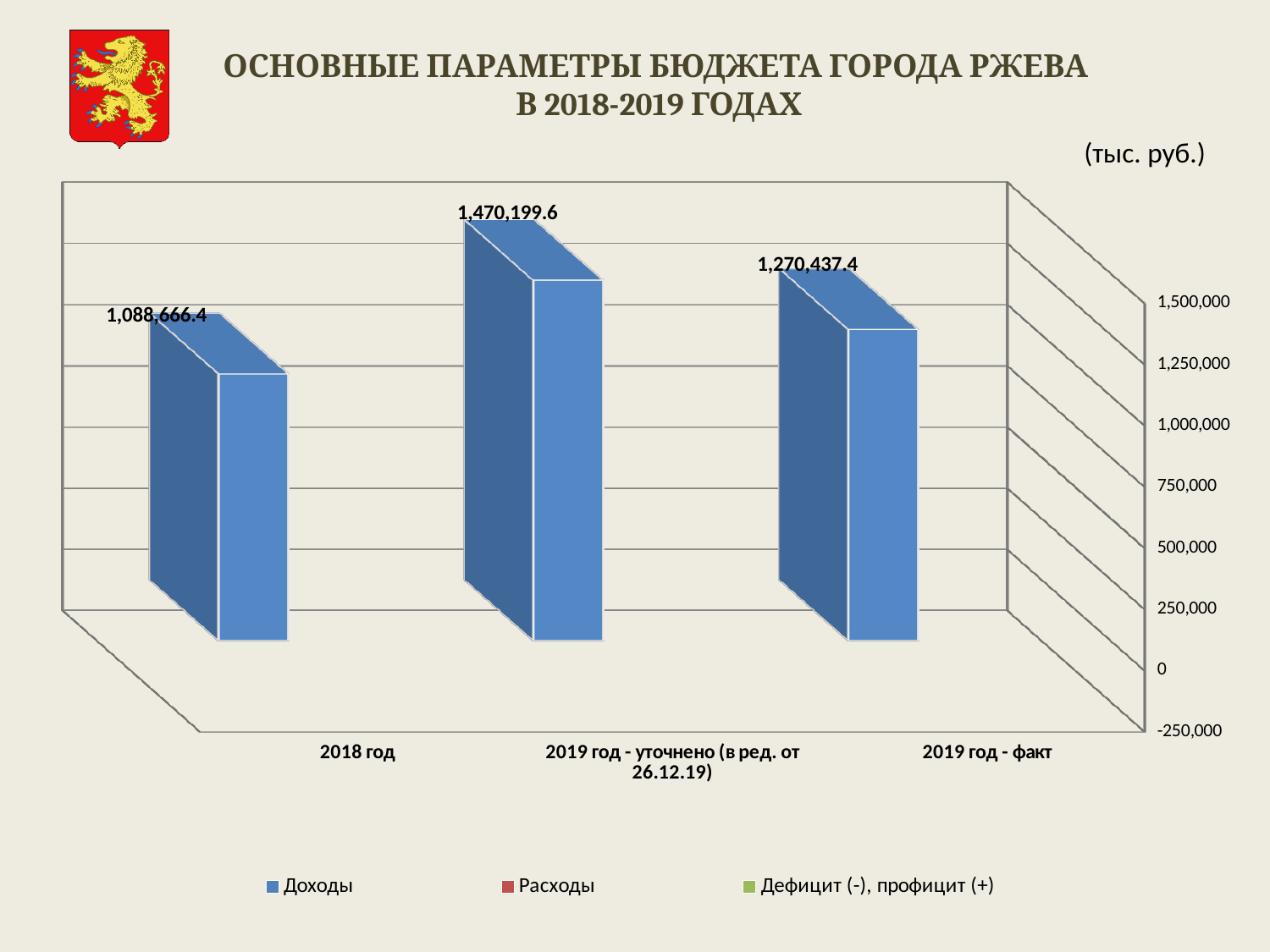
What is the difference between the Доходы values for 2019 год - уточнено (в ред. от 26.12.19) and 2019 год - факт? 199,762.2 What kind of chart is shown on the slide? bar chart Which category has the highest Доходы value? 2019 год - уточнено (в ред. от 26.12.19) Is the Доходы value for 2018 год greater or less than 1,000,000? greater What is the value of Доходы for 2019 год - уточнено (в ред. от 26.12.19)? 1,470,199.6 Which is larger, the Доходы value for 2019 год - факт or for 2018 год? 2019 год - факт How many series does the chart legend list? 3 What is the value of Доходы for 2018 год? 1,088,666.4 What is the difference between the Доходы values for 2019 год - уточнено (в ред. от 26.12.19) and 2018 год? 381,533.2 What is the value of Доходы for 2019 год - факт? 1,270,437.4 Which category has the lowest Доходы value? 2018 год How many categories are shown on the x axis of the chart? 3